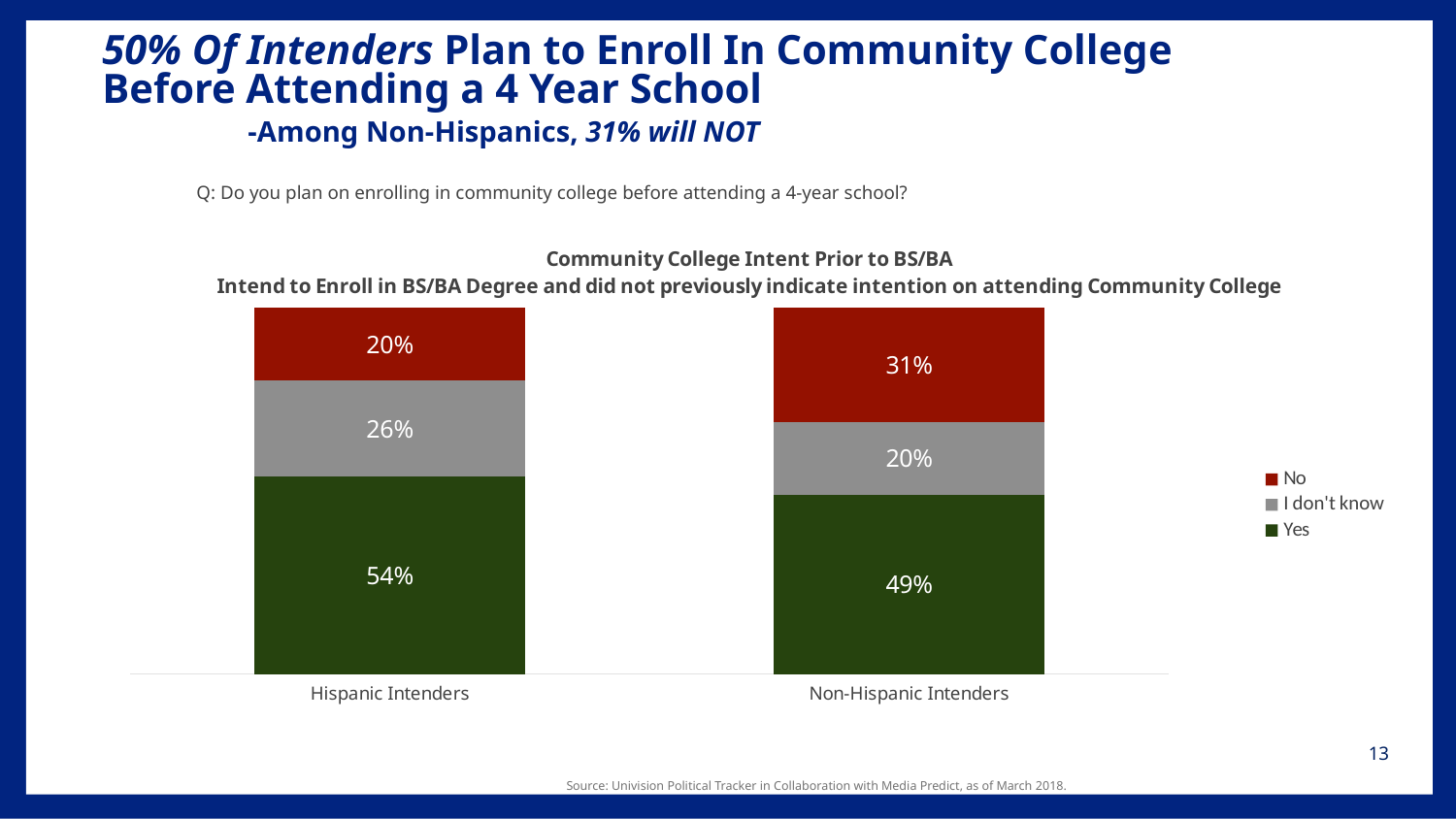
Which colour represents the No response in the legend? Red What is the total of the stacked bar for Hispanic Intenders? 100% What percentage of Hispanic Intenders answered I don't know? 26% Which group has the larger I don't know share? Hispanic Intenders What percentage of Non-Hispanic Intenders answered Yes? 49% How many series does the legend list? 3 Which group has the larger No share, Hispanic Intenders or Non-Hispanic Intenders? Non-Hispanic Intenders What percentage of Non-Hispanic Intenders answered No? 31% What is the difference between the Yes share for Hispanic Intenders and the Yes share for Non-Hispanic Intenders? 5% How many categories are shown on the x axis? 2 What percentage of Hispanic Intenders answered Yes? 54% What kind of chart is shown on the slide? Stacked bar chart